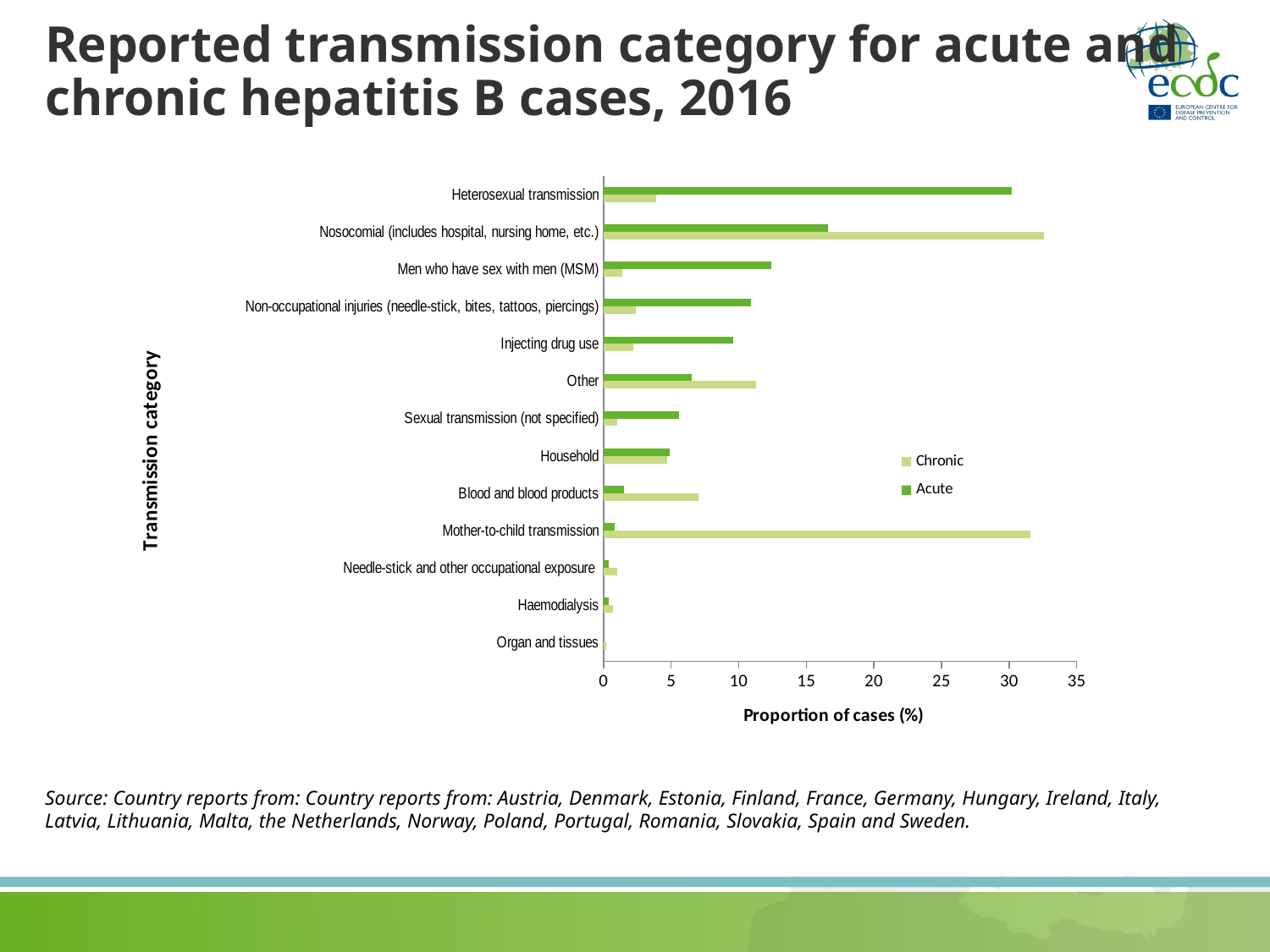
Which transmission category has the lowest Chronic proportion? Organ and tissues How many series does the legend list? 2 Is the Acute value for Men who have sex with men (MSM) greater or less than 15? less How many transmission categories are plotted on the chart? 13 Is the Chronic value for Nosocomial (includes hospital, nursing home, etc.) greater or less than 30? greater For Injecting drug use, which series has the larger value, Chronic or Acute? Acute What is the label of the horizontal axis? Proportion of cases (%) For Other, which series has the larger value, Chronic or Acute? Chronic Is the Chronic value for Mother-to-child transmission greater or less than 30? greater Which transmission category has the highest Acute proportion? Heterosexual transmission What kind of chart is shown on the slide? bar chart